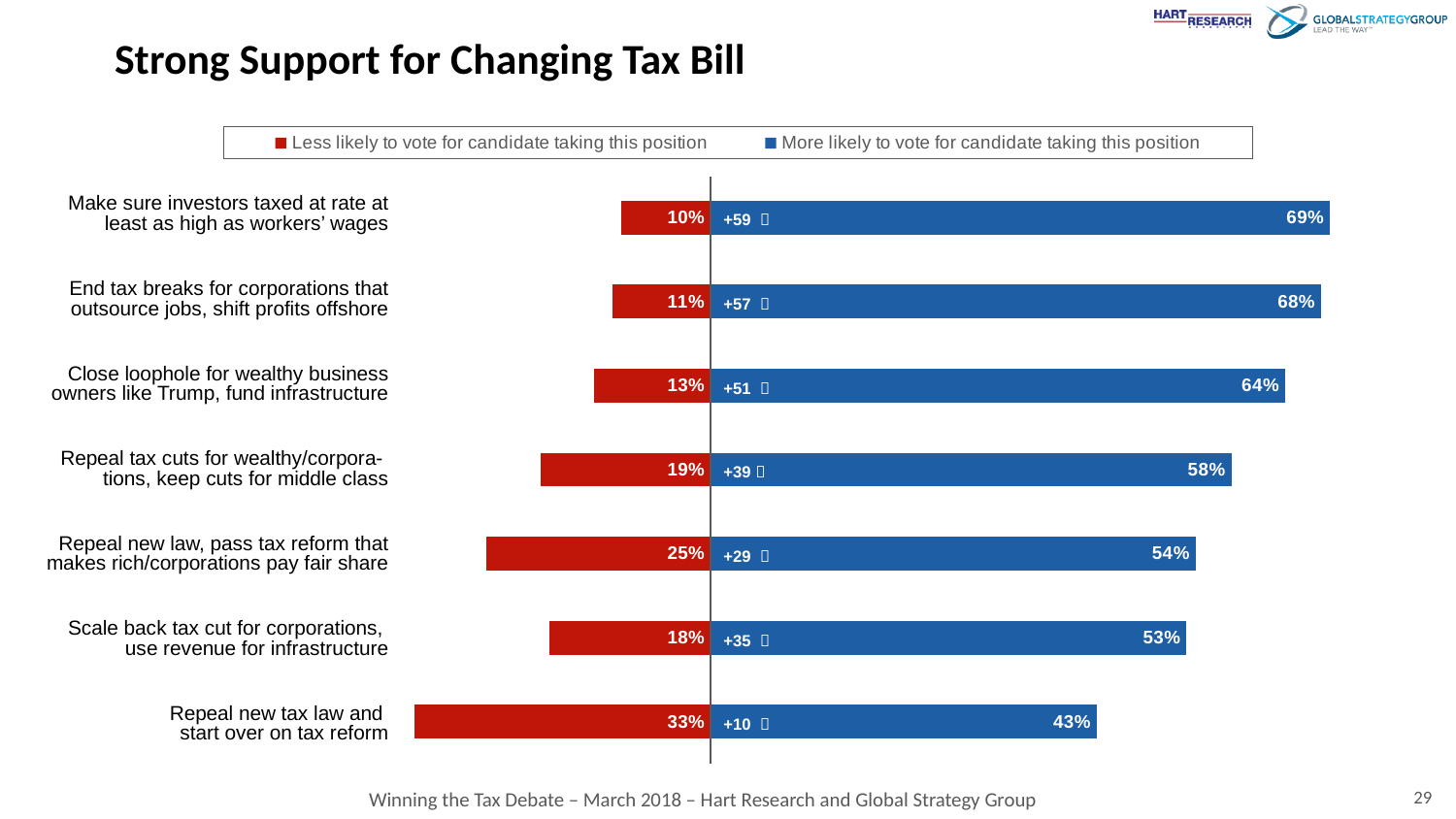
What percentage of respondents are more likely to vote for a candidate who would make sure investors are taxed at a rate at least as high as workers' wages? 69% Which position has the lowest 'Less likely to vote for candidate taking this position' value? Make sure investors taxed at rate at least as high as workers' wages What is the 'More likely' value for 'Close loophole for wealthy business owners like Trump, fund infrastructure'? 64% How many series does the legend list? 2 Which position has the highest 'More likely to vote for candidate taking this position' value? Make sure investors taxed at rate at least as high as workers' wages What colour represents 'Less likely to vote for candidate taking this position'? Red What is the difference between the 'More likely' and 'Less likely' values for 'End tax breaks for corporations that outsource jobs, shift profits offshore'? 57 percentage points What kind of chart is shown on the slide? Bar chart What percentage are less likely to vote for a candidate who would repeal the new tax law and start over on tax reform? 33% How many positions (categories) are shown in the chart? 7 Which position has the highest 'Less likely' value? Repeal new tax law and start over on tax reform Which is larger: the 'More likely' value for 'Scale back tax cut for corporations, use revenue for infrastructure' or for 'Repeal new law, pass tax reform that makes rich/corporations pay fair share'? Repeal new law, pass tax reform that makes rich/corporations pay fair share